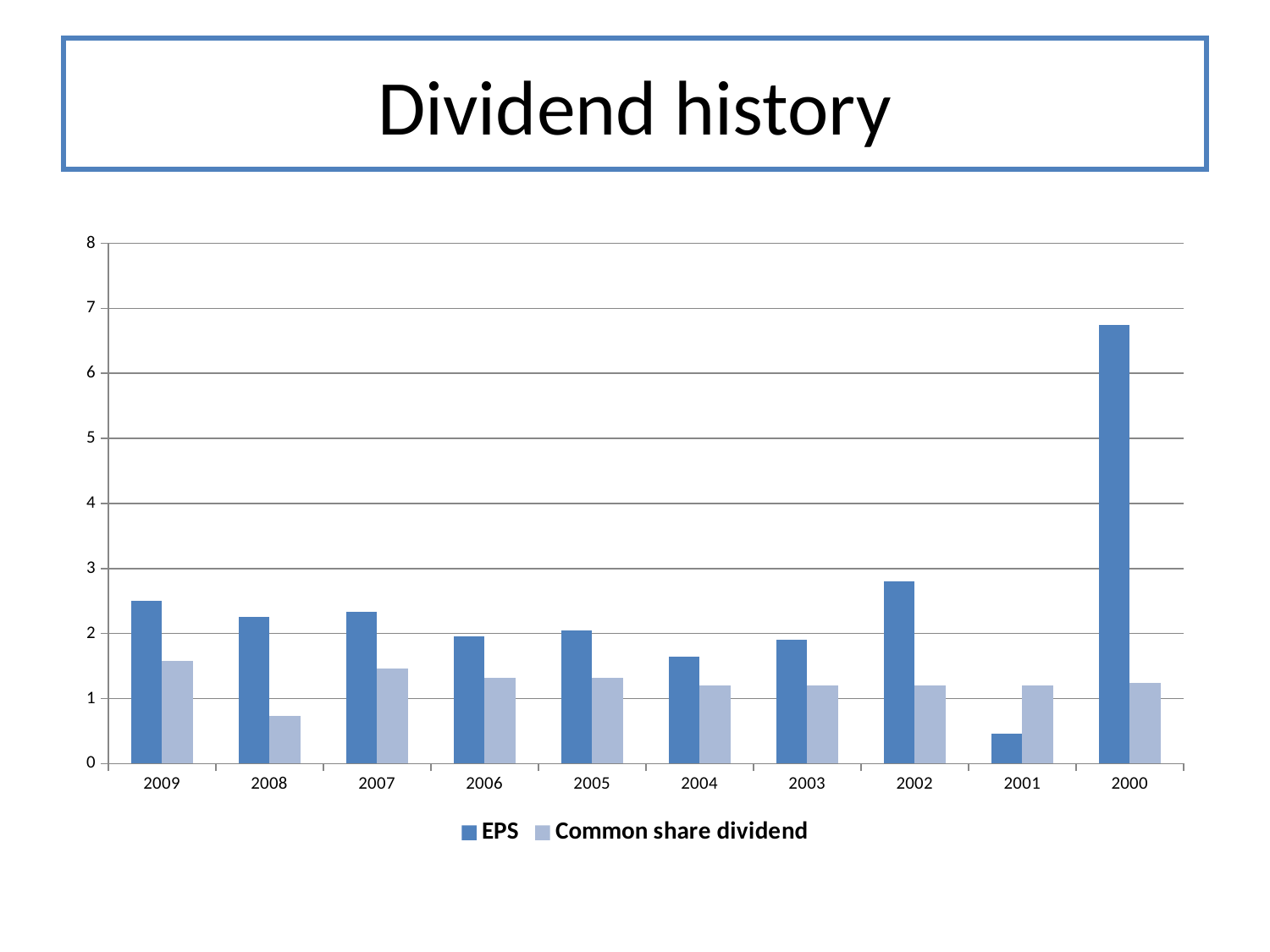
Which year has the highest Common share dividend? 2009 Is the EPS value for 2001 greater or less than 1? less What kind of chart is shown on the slide? Bar chart Which year has the highest EPS? 2000 What is the title of the slide containing the chart? Dividend history How many series does the legend list? 2 How many years are shown on the x axis of the chart? 10 Is the EPS value for 2000 greater or less than 6? greater Which year has the lowest Common share dividend? 2008 Which year has the lowest EPS? 2001 Which year has the larger EPS, 2002 or 2009? 2002 In 2001, which is larger: EPS or Common share dividend? Common share dividend